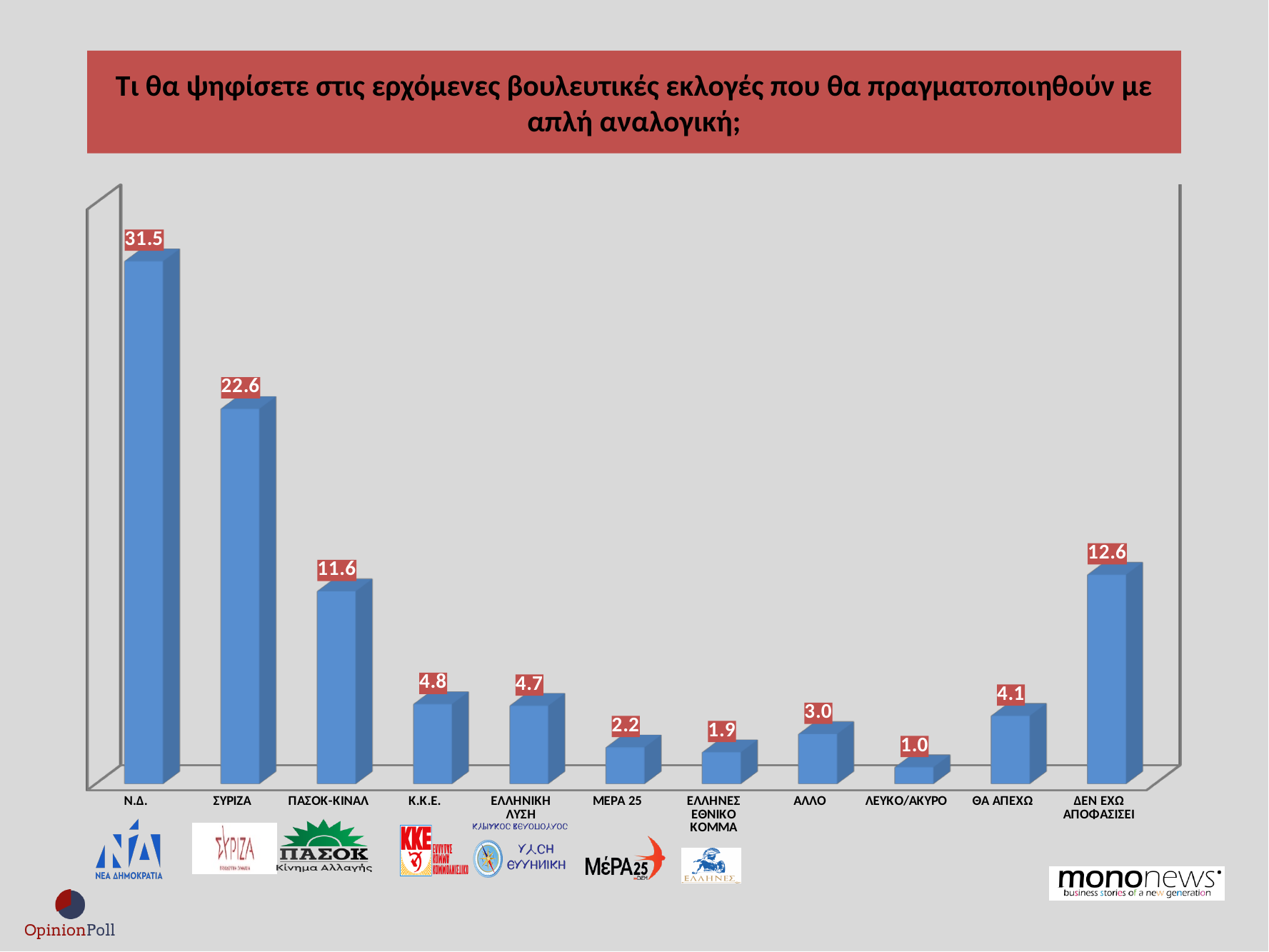
Which category has the lowest value? ΛΕΥΚΟ/ΑΚΥΡΟ What is the value for ΕΛΛΗΝΙΚΗ ΛΥΣΗ? 4.7 What is the value for ΣΥΡΙΖΑ? 22.6 What colour are the bars in the chart? blue What is the difference between the values for ΠΑΣΟΚ-ΚΙΝΑΛ and Κ.Κ.Ε.? 6.8 What kind of chart is shown on the slide? bar chart What is the value for Ν.Δ.? 31.5 Which is larger, the value for ΘΑ ΑΠΕΧΩ or the value for ΑΛΛΟ? ΘΑ ΑΠΕΧΩ How many categories are shown on the x axis? 11 What is the value for ΔΕΝ ΕΧΩ ΑΠΟΦΑΣΙΣΕΙ? 12.6 Which category has the highest value? Ν.Δ. What is the difference between the values for Ν.Δ. and ΣΥΡΙΖΑ? 8.9